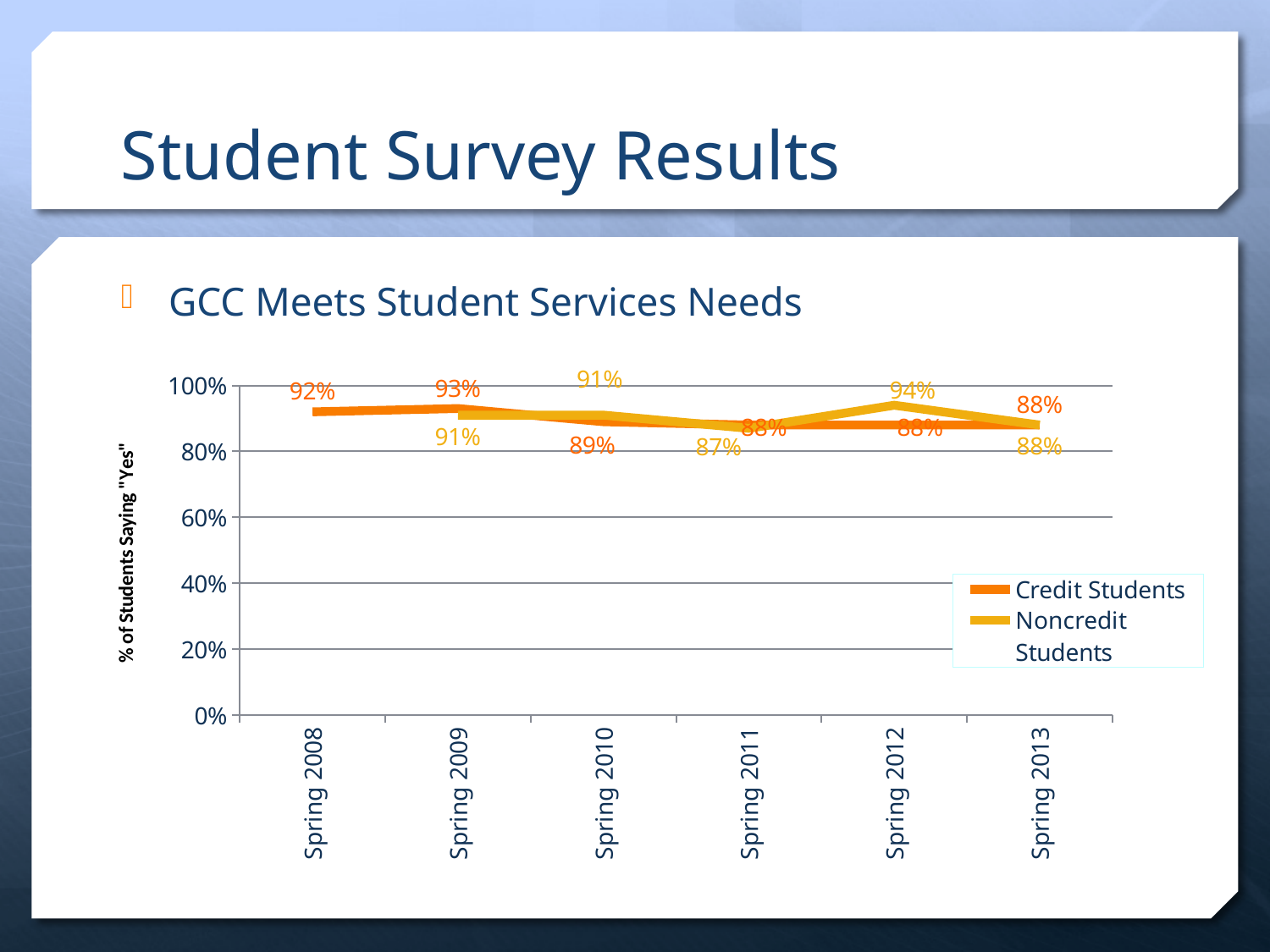
How many survey periods are shown along the x axis? 6 What is the title of the vertical axis? % of Students Saying "Yes" What percentage of Credit Students said "Yes" in Spring 2008? 92% How many series does the chart legend list? 2 What percentage of Credit Students said "Yes" in Spring 2011? 88% In Spring 2010, which series has the higher value, Credit Students or Noncredit Students? Noncredit Students In which survey period was the Noncredit Students value highest? Spring 2012 What percentage of Noncredit Students said "Yes" in Spring 2012? 94% In which survey period was the Noncredit Students value lowest? Spring 2011 In Spring 2012, how many percentage points higher is the Noncredit Students value than the Credit Students value? 6 percentage points In which survey period was the Credit Students value highest? Spring 2009 What type of chart is shown on the slide? Line chart